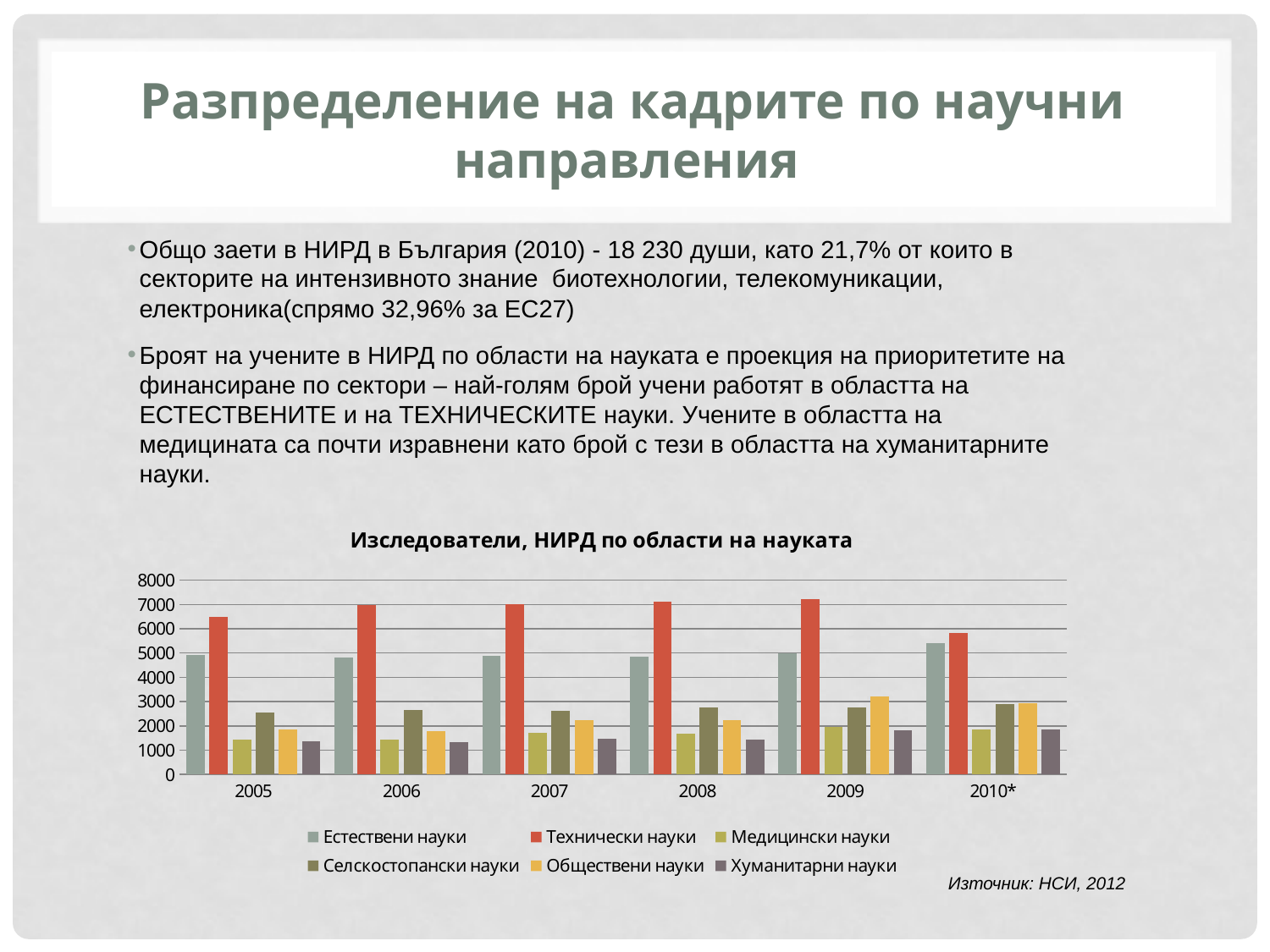
Which is larger in 2010*: Естествени науки or Технически науки? Технически науки Is the value for Технически науки in 2005 greater or less than 7000? less Is the value for Обществени науки in 2009 greater or less than 3000? greater What is the title of the chart? Изследователи, НИРД по области на науката In which year is the value for Естествени науки the highest? 2010* In which year is the value for Технически науки the lowest? 2010* Does the value for Технически науки rise or fall from 2009 to 2010*? fall How many years are shown on the x axis of the chart? 6 What kind of chart is shown on the slide? bar chart How many series does the legend of the chart list? 6 Which is larger in 2009: Селскостопански науки or Обществени науки? Обществени науки Which series has the highest value in 2009? Технически науки